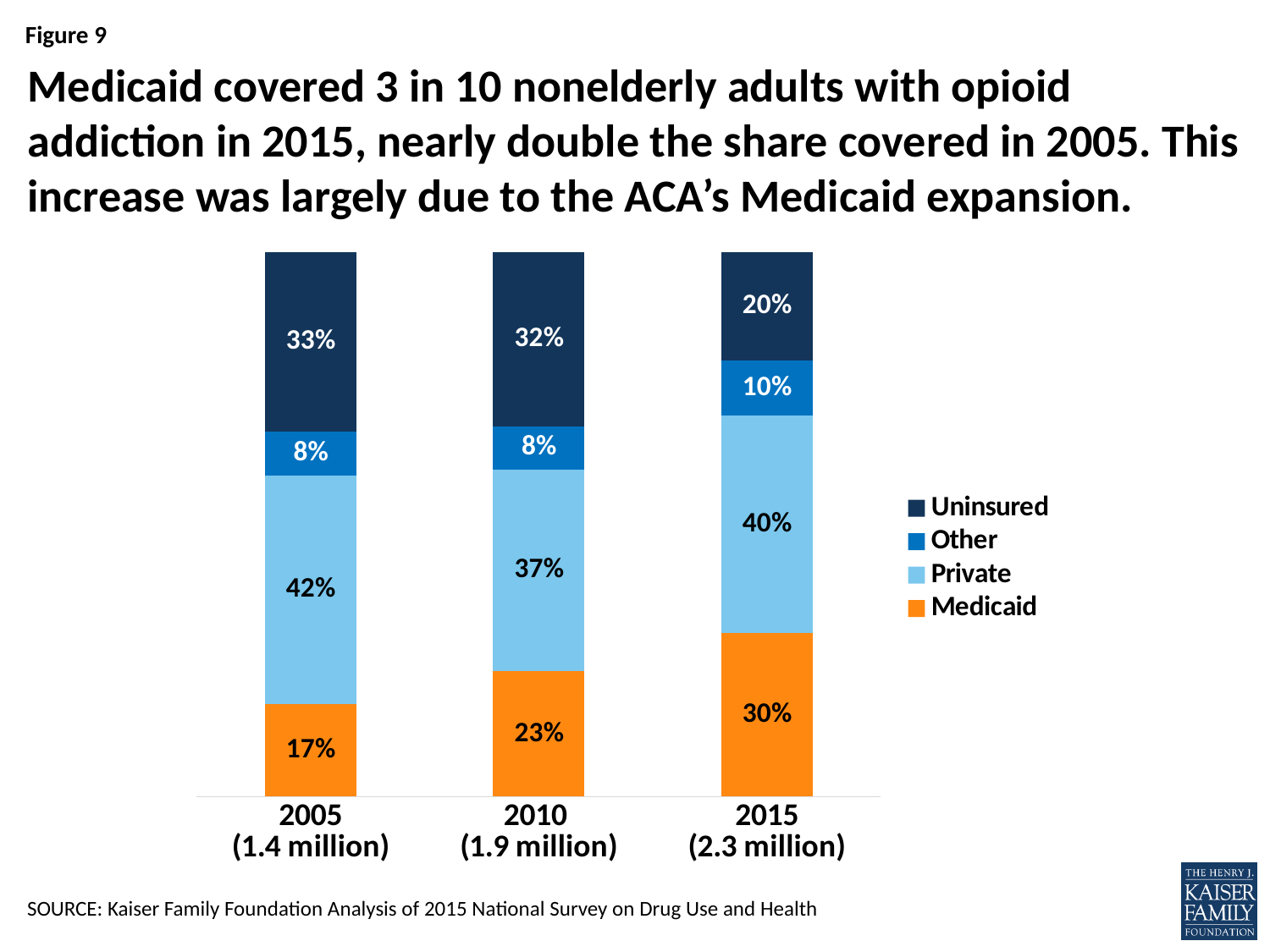
How many series does the legend list? 4 What share of nonelderly adults with opioid addiction was covered by Medicaid in 2015? 30% Which was larger in 2010, the Private share or the Uninsured share? Private What kind of chart is shown on the slide? Stacked bar chart In which year was the Medicaid share highest? 2015 By how many percentage points did the Medicaid share increase from 2005 to 2015? 13 percentage points In which year was the Uninsured share lowest? 2015 How many years are shown on the x axis? 3 Does the Medicaid share rise or fall from 2005 to 2015? Rise What was the Other coverage share in 2015? 10% What was the Uninsured share in 2010? 32% What was the Private coverage share in 2005? 42%